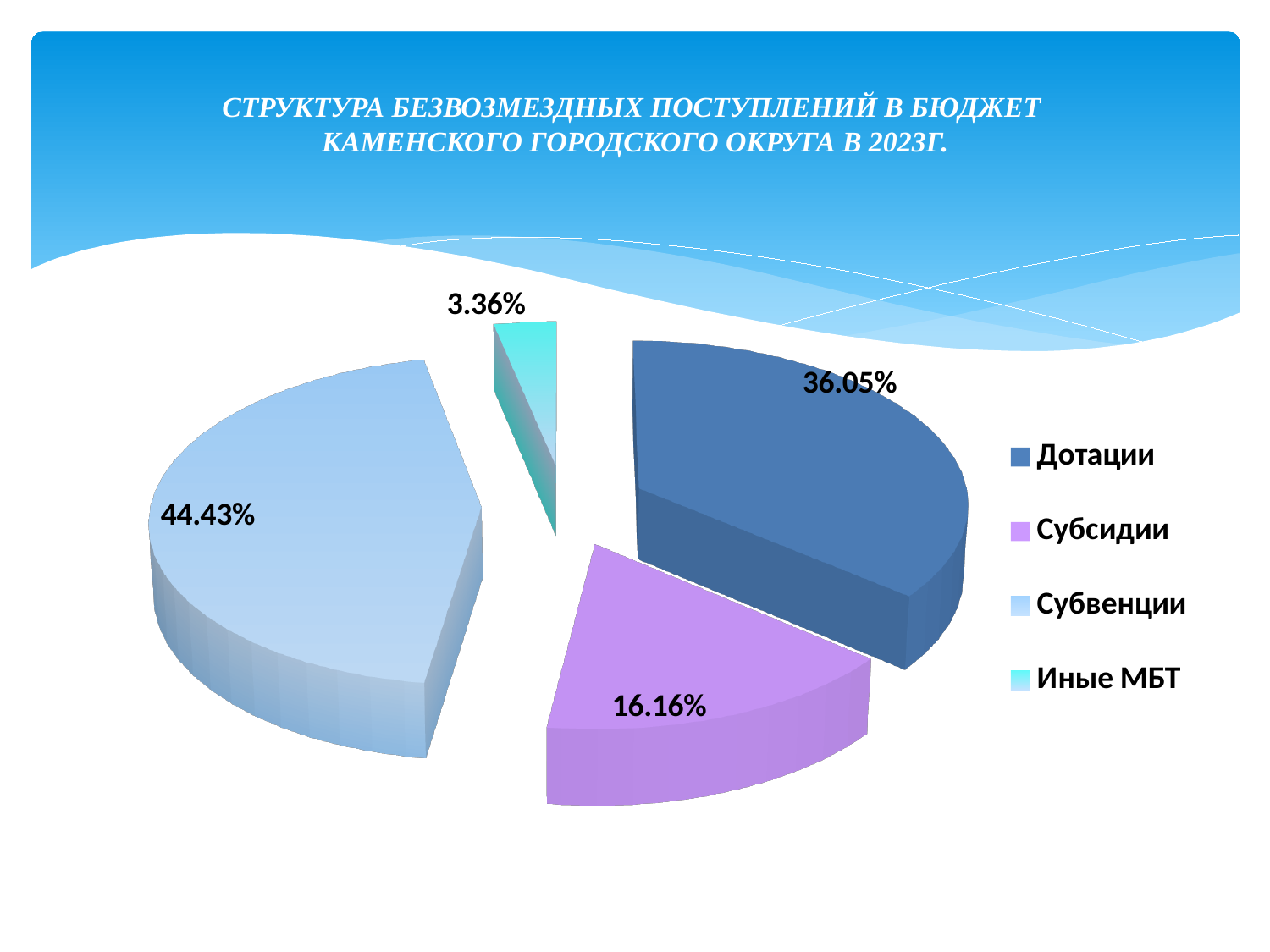
How many categories does the pie chart show? 4 What share of the pie does Субсидии have? 16.16% What is the difference in percentage points between Субвенции and Дотации? 8.38 Which category has the smallest share of the pie? Иные МБТ What share of the pie does Дотации have? 36.05% Which is larger, the share for Дотации or the share for Субсидии? Дотации What is the combined share of Субсидии and Иные МБТ? 19.52% What share of the pie does Субвенции have? 44.43% Which category has the largest share of the pie? Субвенции Which colour represents Субсидии in the legend? Purple What kind of chart is shown on the slide? Pie chart What share of the pie does Иные МБТ have? 3.36%